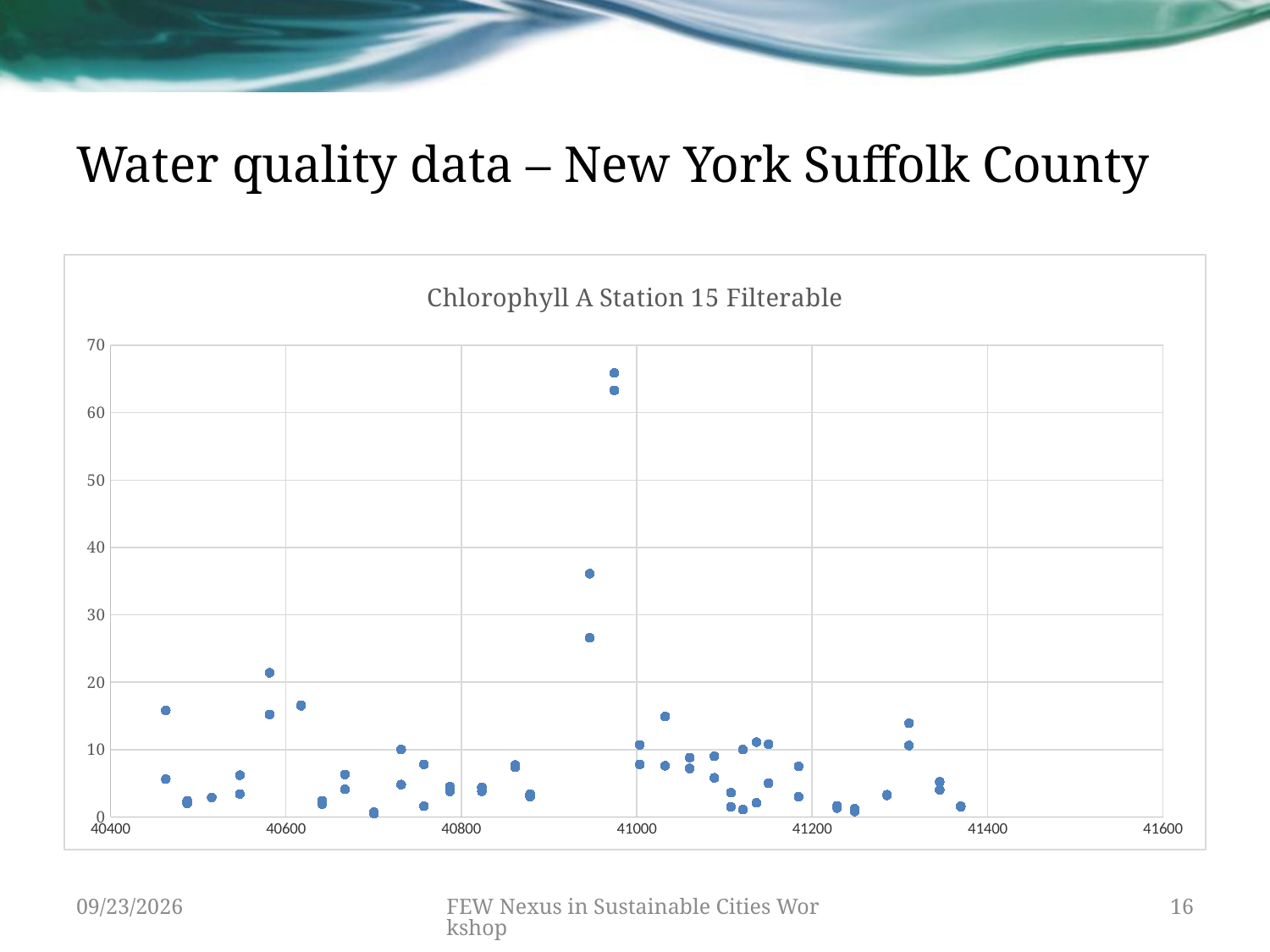
What kind of chart is shown on the slide? scatter chart Is the lowest plotted value in the chart greater or less than 10? less Are any points plotted beyond 41400 on the x axis? No Between which two x-axis ticks do the two highest points in the chart fall? 40800 and 41000 How many points in the chart have a value above 60? 2 Are the points plotted between 41200 and 41400 on the x axis all below 20? Yes Is the highest plotted value in the chart greater or less than 70? less How many points in the chart have a value above 20? 5 What is the title of the chart? Chlorophyll A Station 15 Filterable